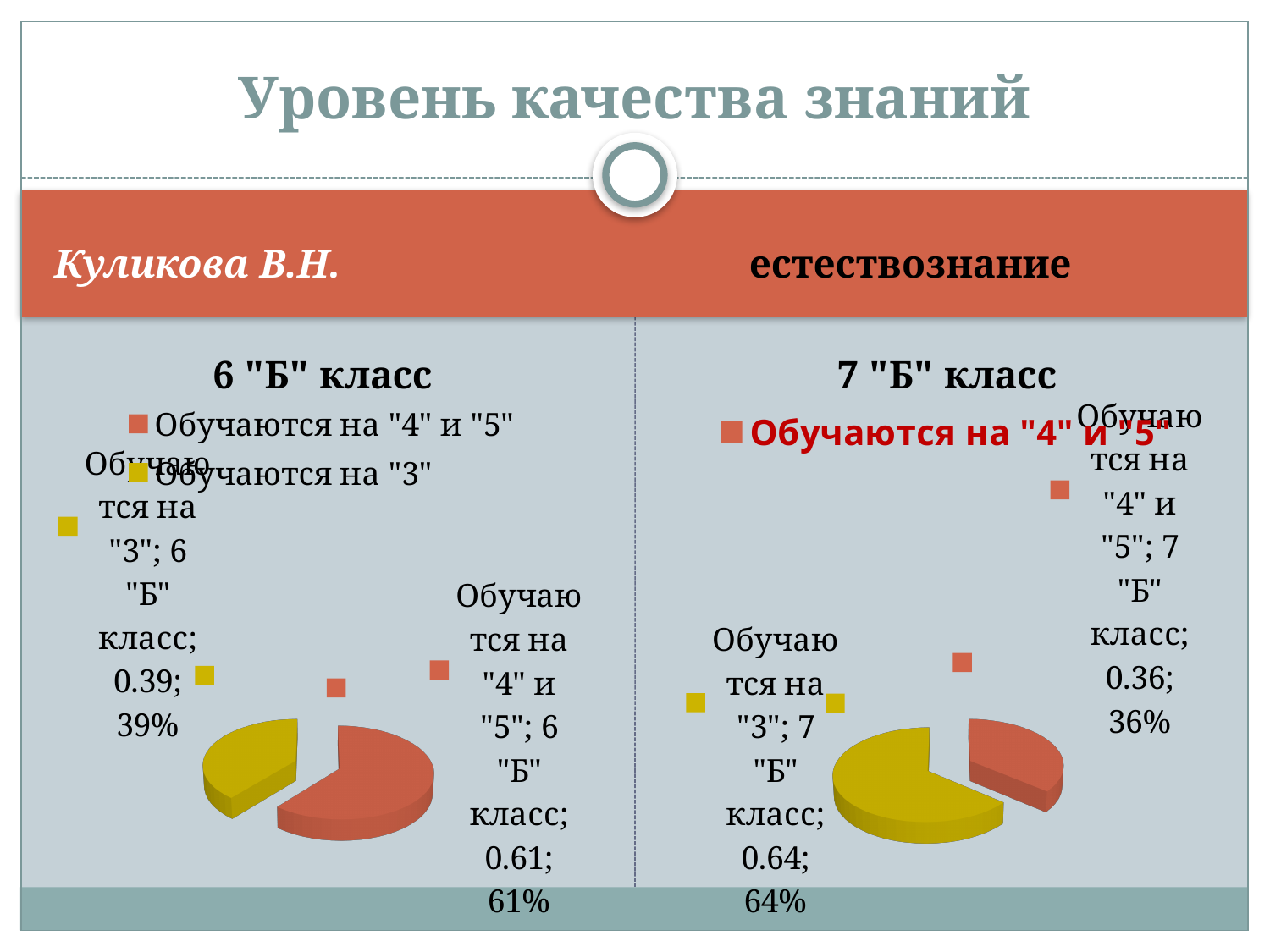
In the "6 "Б" класс" chart, what percentage of students are "Обучаются на "4" и "5""? 61% In the "7 "Б" класс" chart, what percentage of students are "Обучаются на "3""? 64% In the "6 "Б" класс" chart, what is the difference in percentage points between the "4" и "5" slice and the "3" slice? 22 In the "7 "Б" класс" chart, which category has the smallest slice? Обучаются на "4" и "5" Which chart shows a larger share of students "Обучаются на "4" и "5"": "6 "Б" класс" or "7 "Б" класс"? 6 "Б" класс In the "6 "Б" класс" chart, which category has the largest slice? Обучаются на "4" и "5" How many slices does the "7 "Б" класс" pie chart have? 2 In the "7 "Б" класс" chart, what percentage of students are "Обучаются на "4" и "5""? 36% What type of chart is used for "6 "Б" класс"? Pie chart In the "6 "Б" класс" chart, what colour is the "Обучаются на "3"" slice? Yellow In the "6 "Б" класс" chart, what percentage of students are "Обучаются на "3""? 39% How many entries does the legend of the "6 "Б" класс" chart list? 2